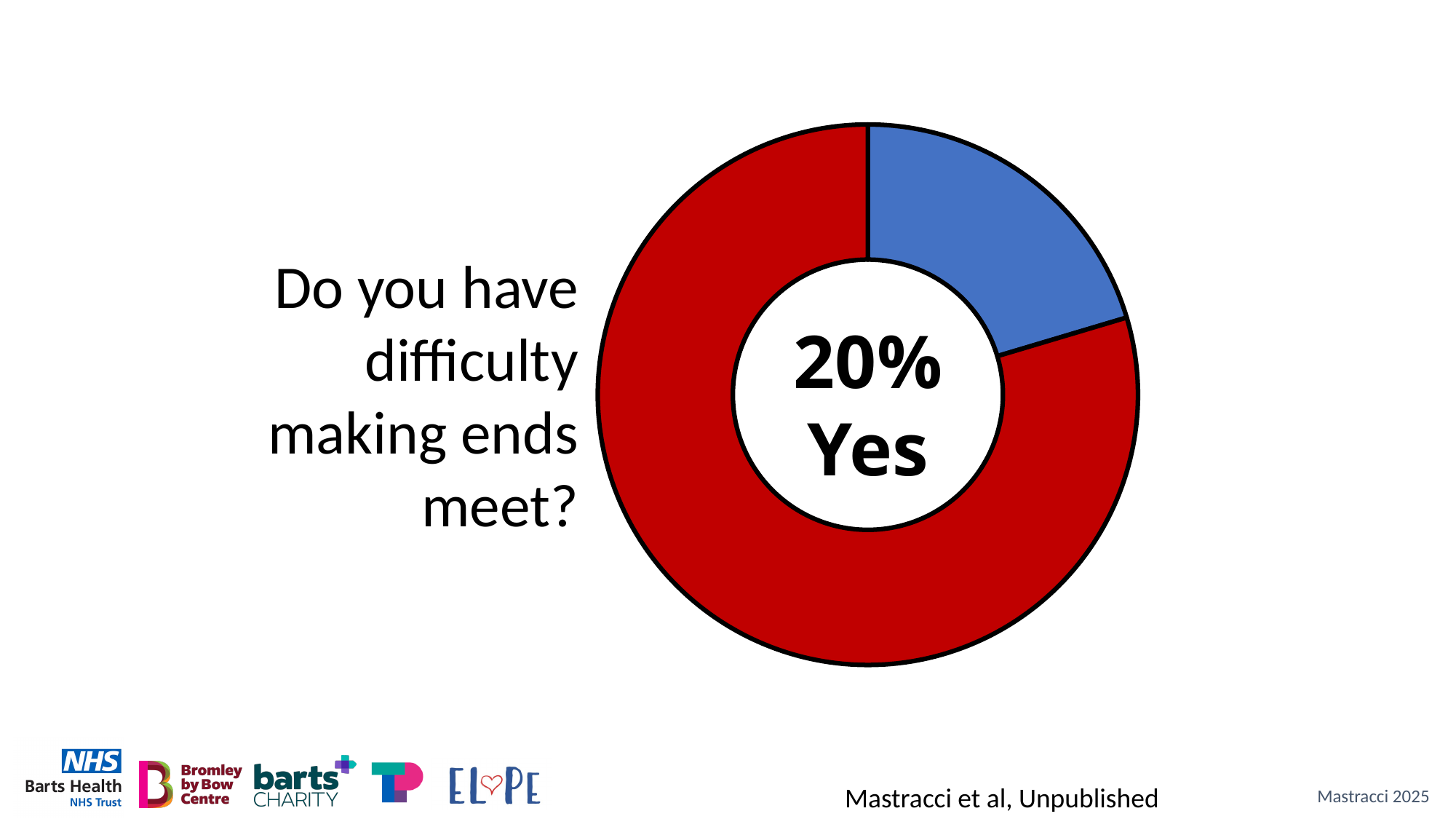
Which slice is the smallest in the chart? the blue (Yes) slice What share of the chart does the Yes slice represent? 20% Is the Yes share greater or less than 50%? less What share of the chart does the red slice represent? 80% Which slice is the largest in the chart? the red slice Which slice is larger, the red slice or the blue slice? red What colour is the slice representing Yes responses? blue What percentage of respondents answered Yes to having difficulty making ends meet? 20% What kind of chart is shown on the slide? donut (pie) chart What survey question does the chart relate to? Do you have difficulty making ends meet? How many slices does the chart have? 2